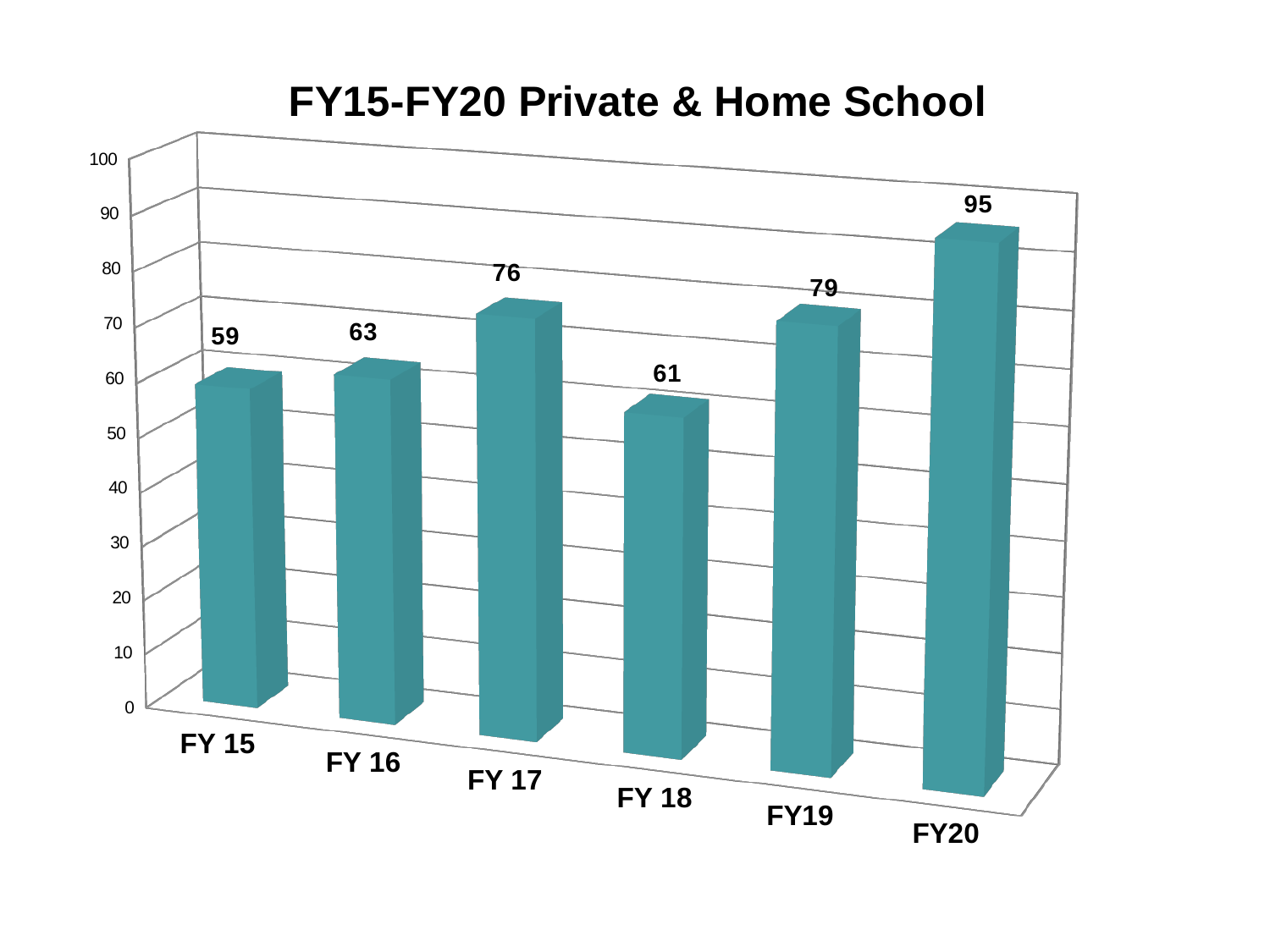
What kind of chart is shown on the slide? bar chart Which fiscal year has the lowest value? FY 15 Which is larger, the value for FY 16 or the value for FY 18? FY 16 What is the value for FY 18? 61 What is the value for FY20? 95 What is the difference between the values for FY 17 and FY 18? 15 Is the value for FY19 greater or less than 70? greater What is the title of the chart? FY15-FY20 Private & Home School What is the difference between the values for FY20 and FY19? 16 How many fiscal years are shown on the chart? 6 Which fiscal year has the highest value? FY20 What is the value for FY 17? 76